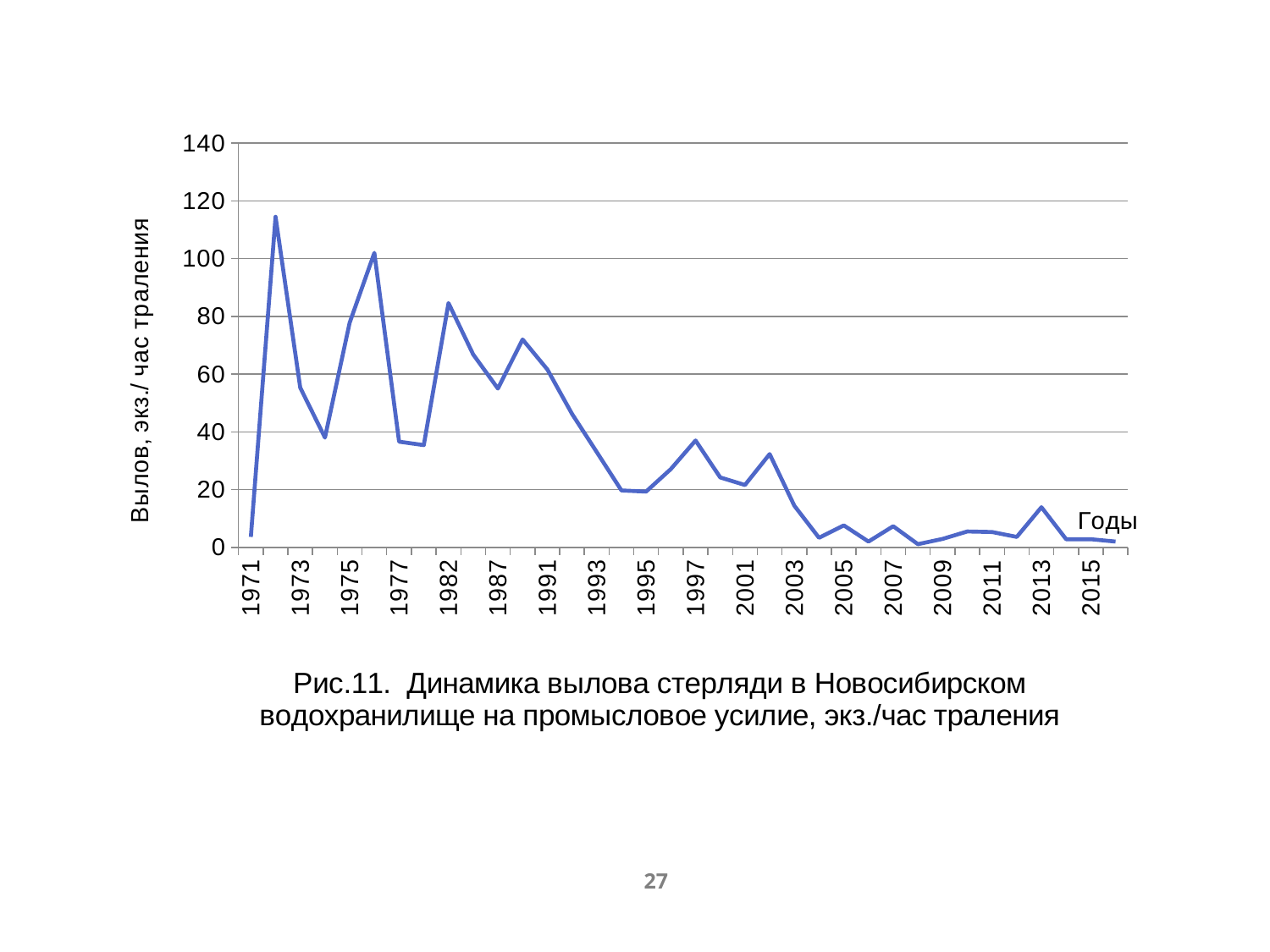
Which year has the larger value, 2013 or 1975? 1975 Overall, do the values rise or fall from 1971 to 2015? fall Is the value for 1973 greater or less than 40? greater What kind of chart is shown on the slide? line chart What is the label of the vertical axis? Вылов, экз./ час траления Is the value for 1971 greater or less than 20? less Which year has the larger value, 1982 or 1995? 1982 Is the value for 1975 greater or less than 60? greater